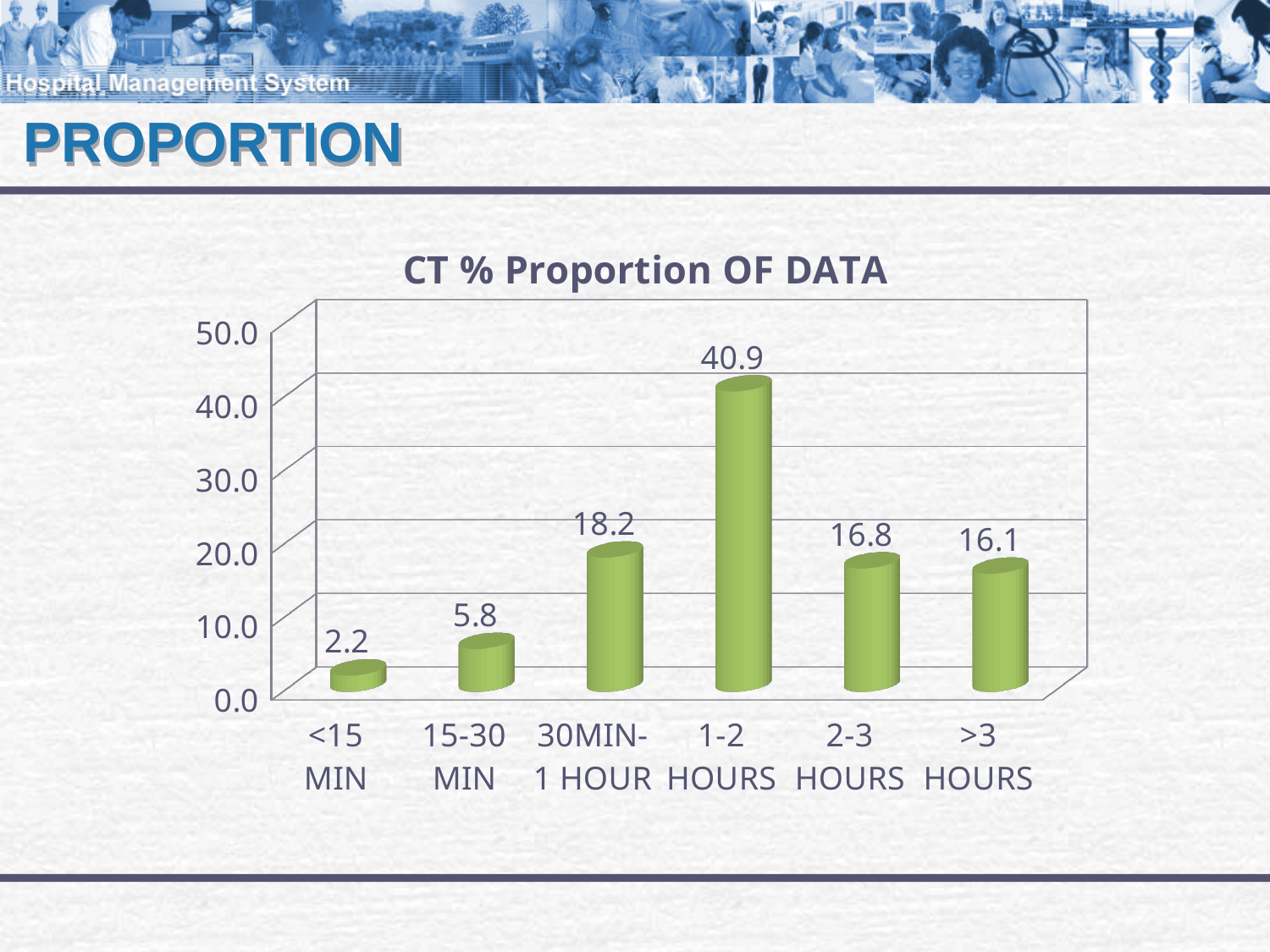
Which category has the lowest value? <15 MIN What kind of chart is shown on the slide? bar chart What is the title of the chart? CT % Proportion OF DATA What is the difference between the values for 15-30 MIN and <15 MIN? 3.6 What is the value for the 30MIN-1 HOUR category? 18.2 Which is larger, the value for 30MIN-1 HOUR or the value for >3 HOURS? 30MIN-1 HOUR What is the difference between the values for 1-2 HOURS and 2-3 HOURS? 24.1 How many categories are shown on the x axis? 6 Is the value for 1-2 HOURS greater or less than 30.0? greater What is the value for the 1-2 HOURS category? 40.9 What is the value for the <15 MIN category? 2.2 Which category has the highest value? 1-2 HOURS